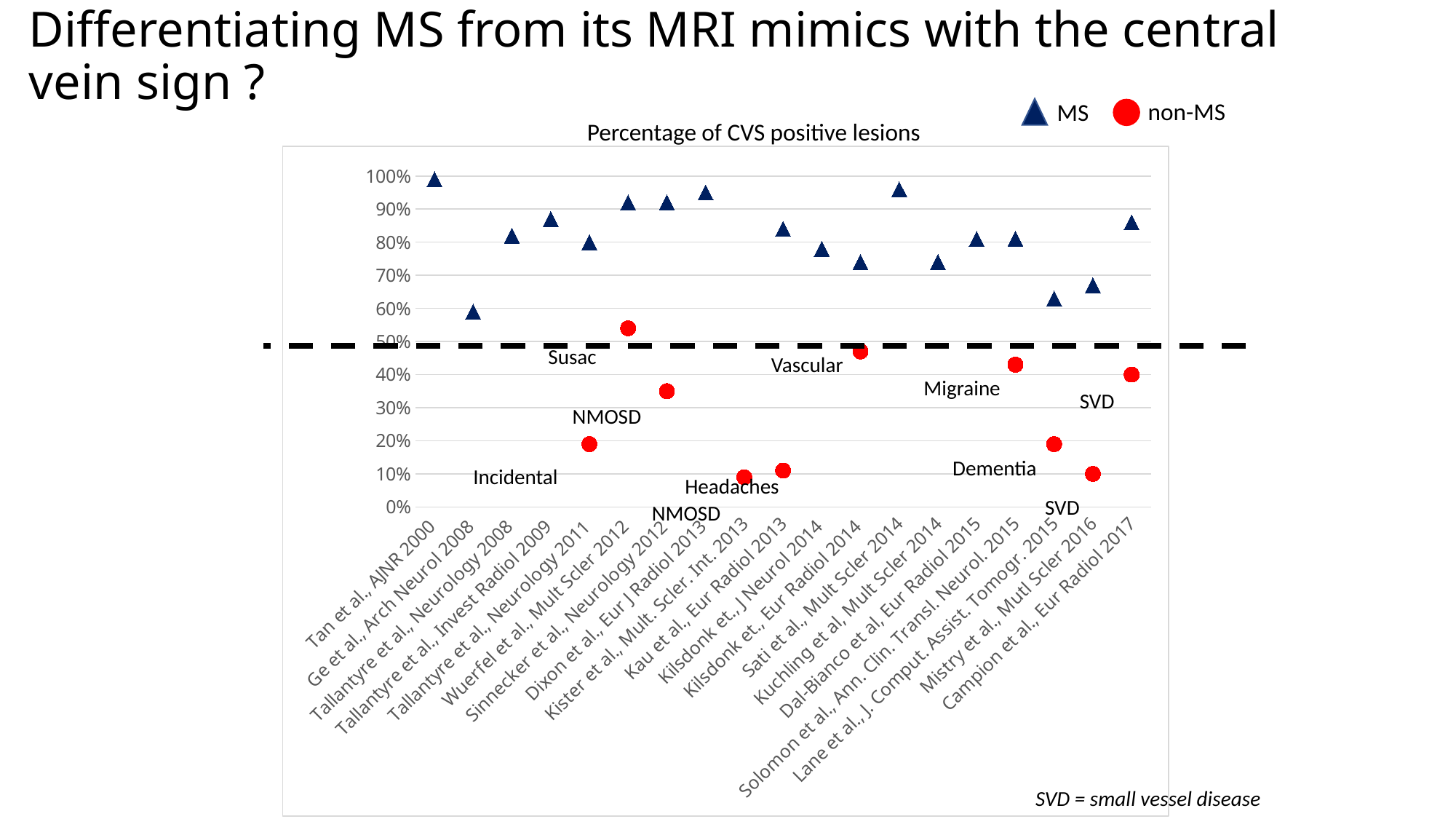
Is the MS value for Mistry et al., Mutl Scler 2016 greater or less than 70%? less Which study has the highest non-MS value? Wuerfel et al., Mult Scler 2012 Which study has the highest MS value? Tan et al., AJNR 2000 Which study has the lowest MS value? Ge et al., Arch Neurol 2008 How many series does the legend list? 2 Is the non-MS value for Wuerfel et al., Mult Scler 2012 greater or less than 50%? greater What kind of chart is shown on the slide? scatter chart Which is larger, the MS value for Wuerfel et al., Mult Scler 2012 or the MS value for Tallantyre et al., Neurology 2011? Wuerfel et al., Mult Scler 2012 What is the title of the chart? Percentage of CVS positive lesions Is the non-MS value for Sinnecker et al., Neurology 2012 greater or less than 40%? less How many studies are listed along the x axis? 19